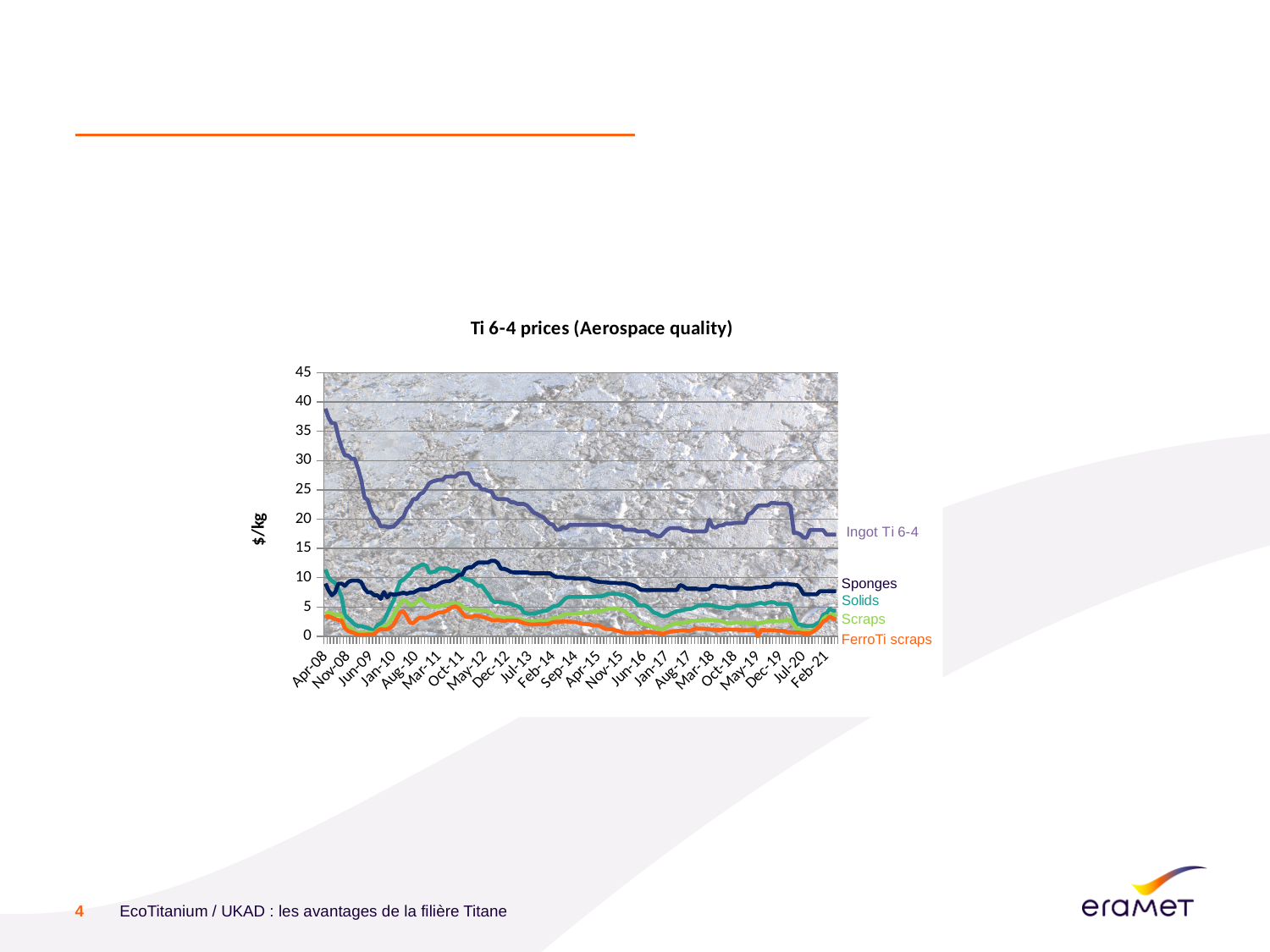
Is the value for Sponges at Feb-21 greater or less than 10? less Is the value for Ingot Ti 6-4 at Apr-08 greater or less than 35? greater At Feb-21, which is larger: the Sponges price or the Solids price? Sponges What is the highest value shown on the vertical axis? 45 Which series has the highest prices across the whole period? Ingot Ti 6-4 How many series are plotted on the chart? 5 Which series has the lowest prices across the whole period? FerroTi scraps What is the title of the chart? Ti 6-4 prices (Aerospace quality) Is the value for Ingot Ti 6-4 at Feb-21 greater or less than 20? less What kind of chart is shown on the slide? Line chart Does the Ingot Ti 6-4 price rise or fall between Apr-08 and Jun-09? Fall What is the label of the vertical axis? $/kg